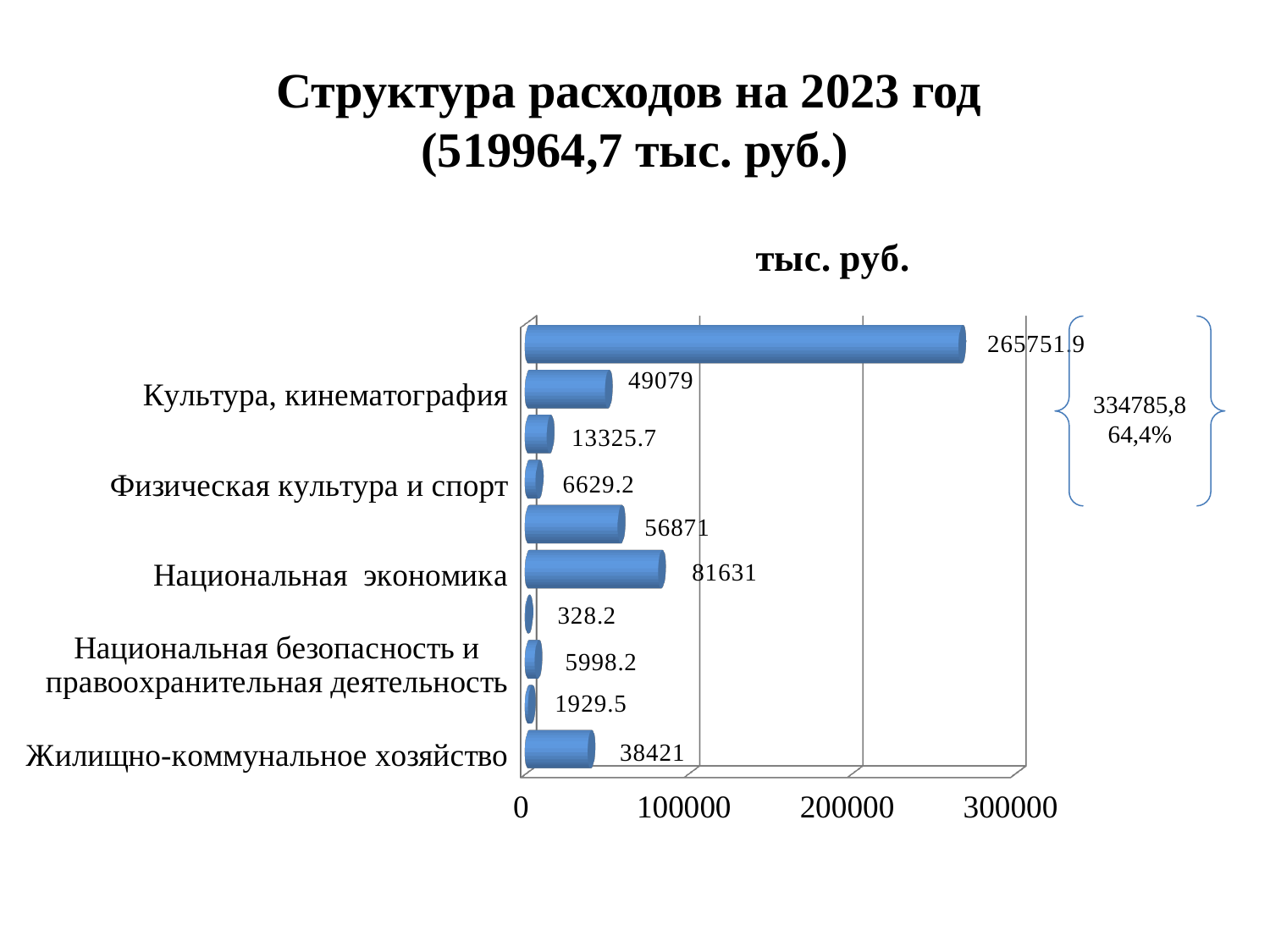
What kind of chart is shown on the slide? Bar chart What is the value for Национальная экономика? 81631 Which is larger, the value for Культура, кинематография or the value for Жилищно-коммунальное хозяйство? Культура, кинематография What is the title of the chart on the slide? тыс. руб. What is the value for Культура, кинематография? 49079 What is the value of the shortest bar in the chart? 328.2 What is the value of the longest bar in the chart? 265751.9 What is the value for Национальная безопасность и правоохранительная деятельность? 5998.2 How many bars are plotted in the chart? 10 What is the value for Жилищно-коммунальное хозяйство? 38421 What is the difference between the values for Национальная экономика and Жилищно-коммунальное хозяйство? 43210 What is the value for Физическая культура и спорт? 6629.2